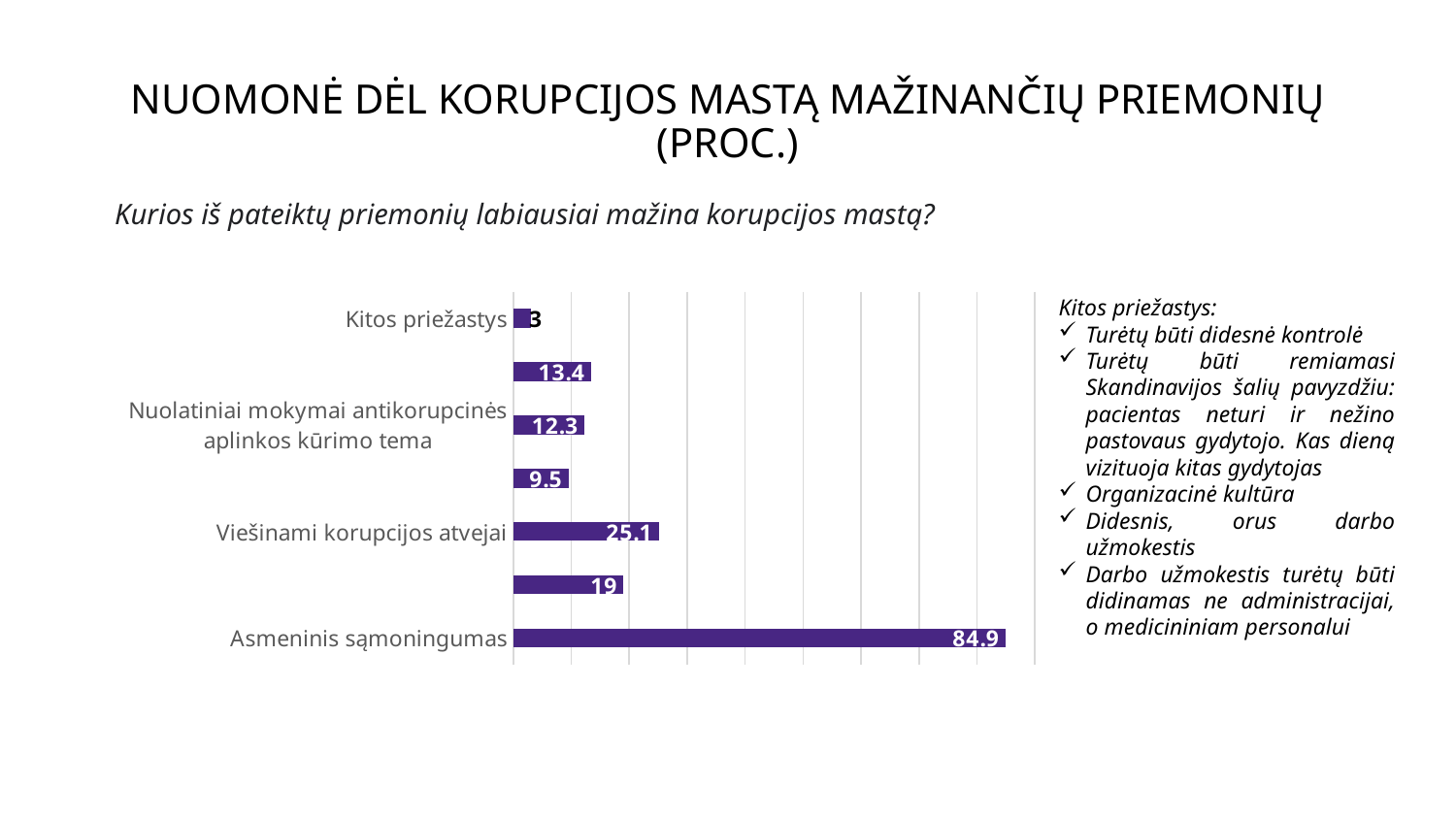
What is the value for Kitos priežastys? 3 What is the difference between the values for Asmeninis sąmoningumas and Viešinami korupcijos atvejai? 59.8 Which category has the lowest value? Kitos priežastys What kind of chart is shown on the slide? Bar chart What is the value for Asmeninis sąmoningumas? 84.9 What is the difference between the values for Viešinami korupcijos atvejai and Nuolatiniai mokymai antikorupcinės aplinkos kūrimo tema? 12.8 Which is larger, the value for Viešinami korupcijos atvejai or the value for Nuolatiniai mokymai antikorupcinės aplinkos kūrimo tema? Viešinami korupcijos atvejai What is the title of the slide containing the chart? NUOMONĖ DĖL KORUPCIJOS MASTĄ MAŽINANČIŲ PRIEMONIŲ (PROC.) Which category has the highest value? Asmeninis sąmoningumas What is the value for Nuolatiniai mokymai antikorupcinės aplinkos kūrimo tema? 12.3 What is the value for Viešinami korupcijos atvejai? 25.1 How many bars are plotted in the chart? 7